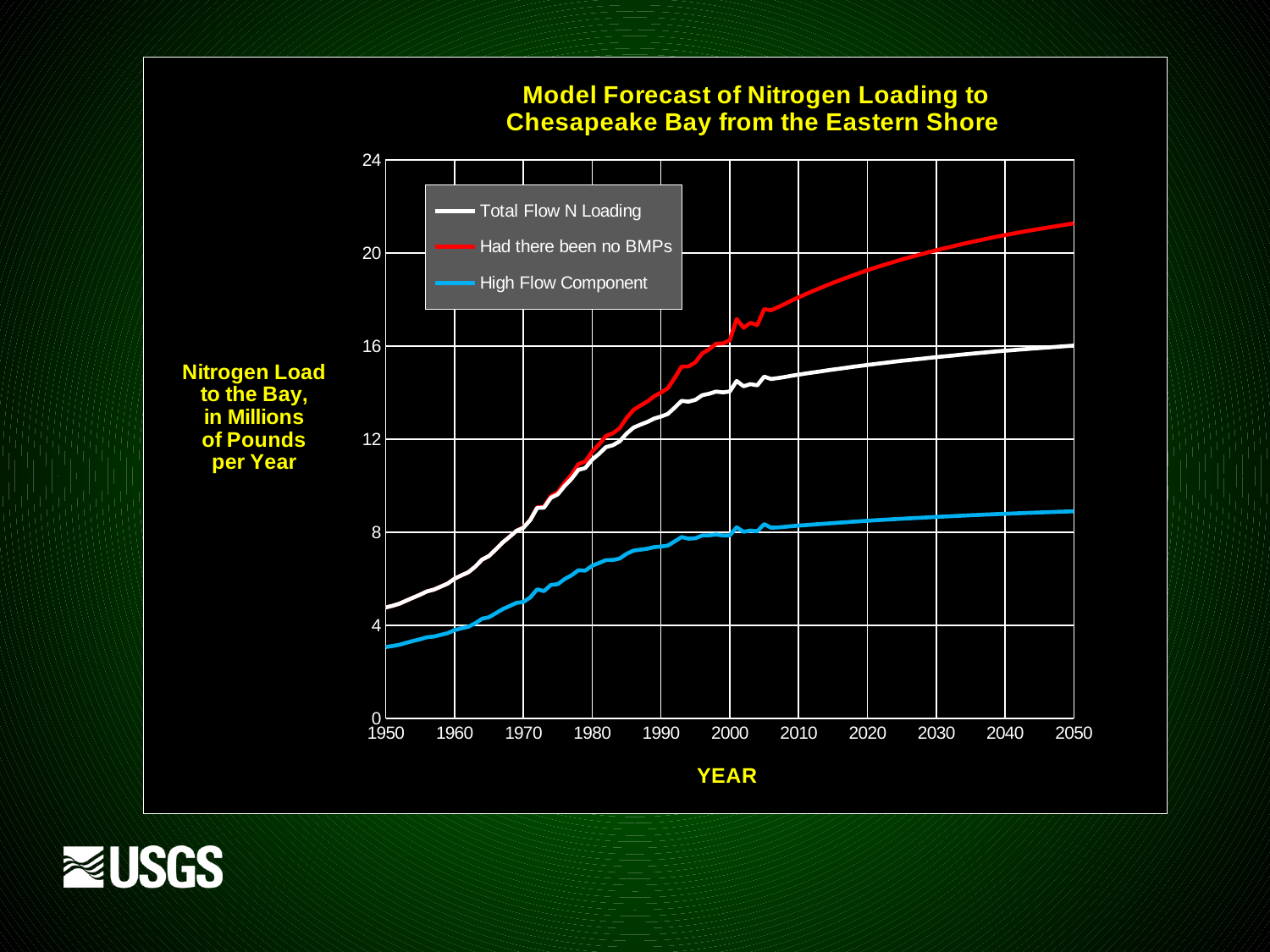
Is the value for Total Flow N Loading in 2000 greater or less than 12? greater What kind of chart is shown on the slide? line chart What is the title of the chart? Model Forecast of Nitrogen Loading to Chesapeake Bay from the Eastern Shore Is the value for High Flow Component in 1950 greater or less than 4? less Do the values for Total Flow N Loading rise or fall from 1950 to 2050? rise In 2050, which is larger: Total Flow N Loading or Had there been no BMPs? Had there been no BMPs Which series has the lowest values across the whole period? High Flow Component Is the value for High Flow Component in 2050 greater or less than 8? greater How many series does the legend list? 3 What colour is the line for High Flow Component? blue